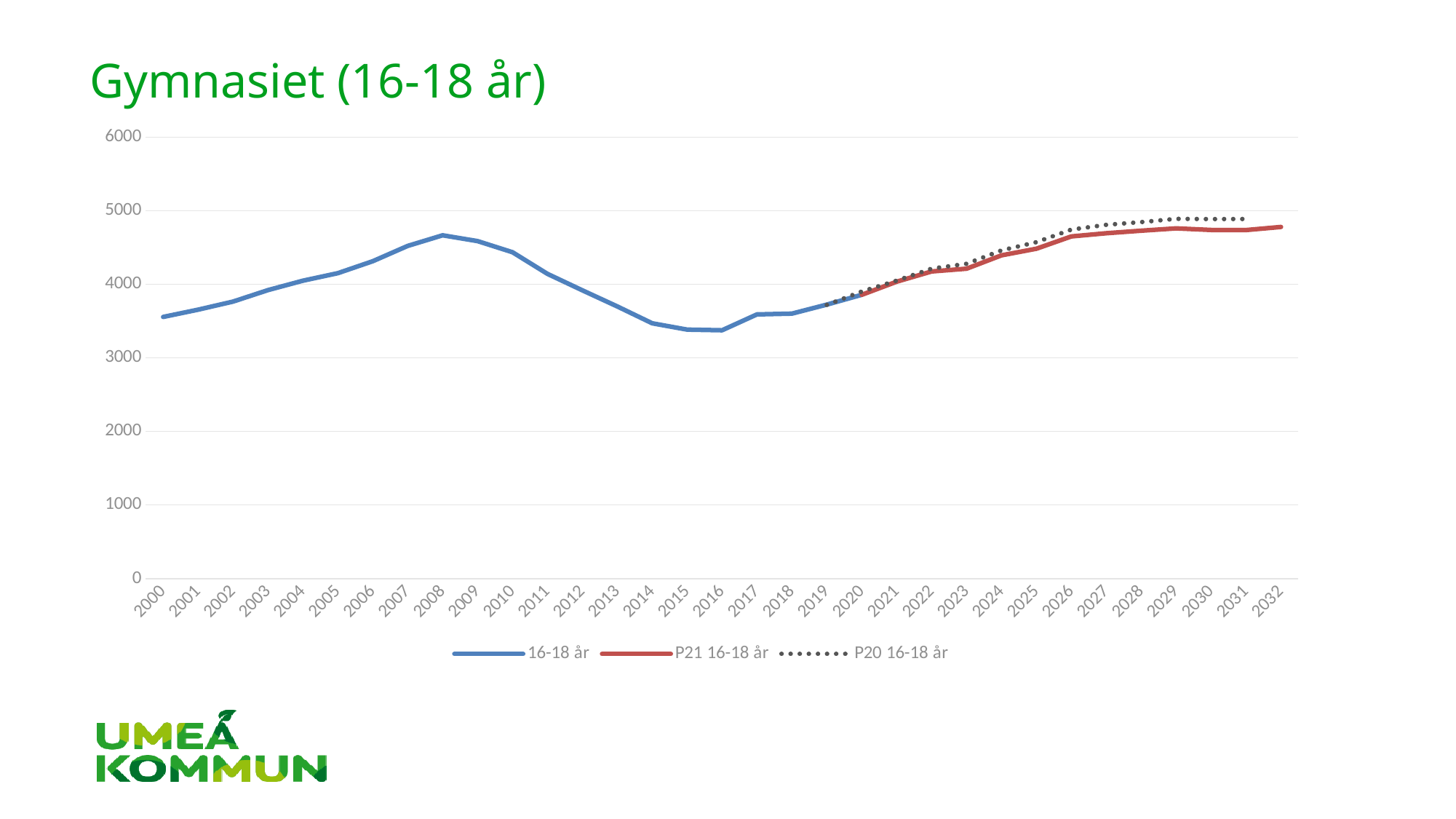
Is the value of the '16-18 år' line in 2008 greater or less than 4000? greater What kind of chart is shown on the slide? line chart In 2031, which series has the higher value: 'P20 16-18 år' or 'P21 16-18 år'? P20 16-18 år What is the title of the slide? Gymnasiet (16-18 år) Is the value of the 'P21 16-18 år' line in 2032 greater or less than 5000? less In which year does the blue '16-18 år' line reach its highest value? 2008 How many series does the legend list? 3 Does the '16-18 år' line rise or fall between 2008 and 2016? fall How many years are shown on the x axis? 33 Is the value of the '16-18 år' line in 2016 greater or less than 3500? less Does the 'P21 16-18 år' line rise or fall between 2020 and 2032? rise